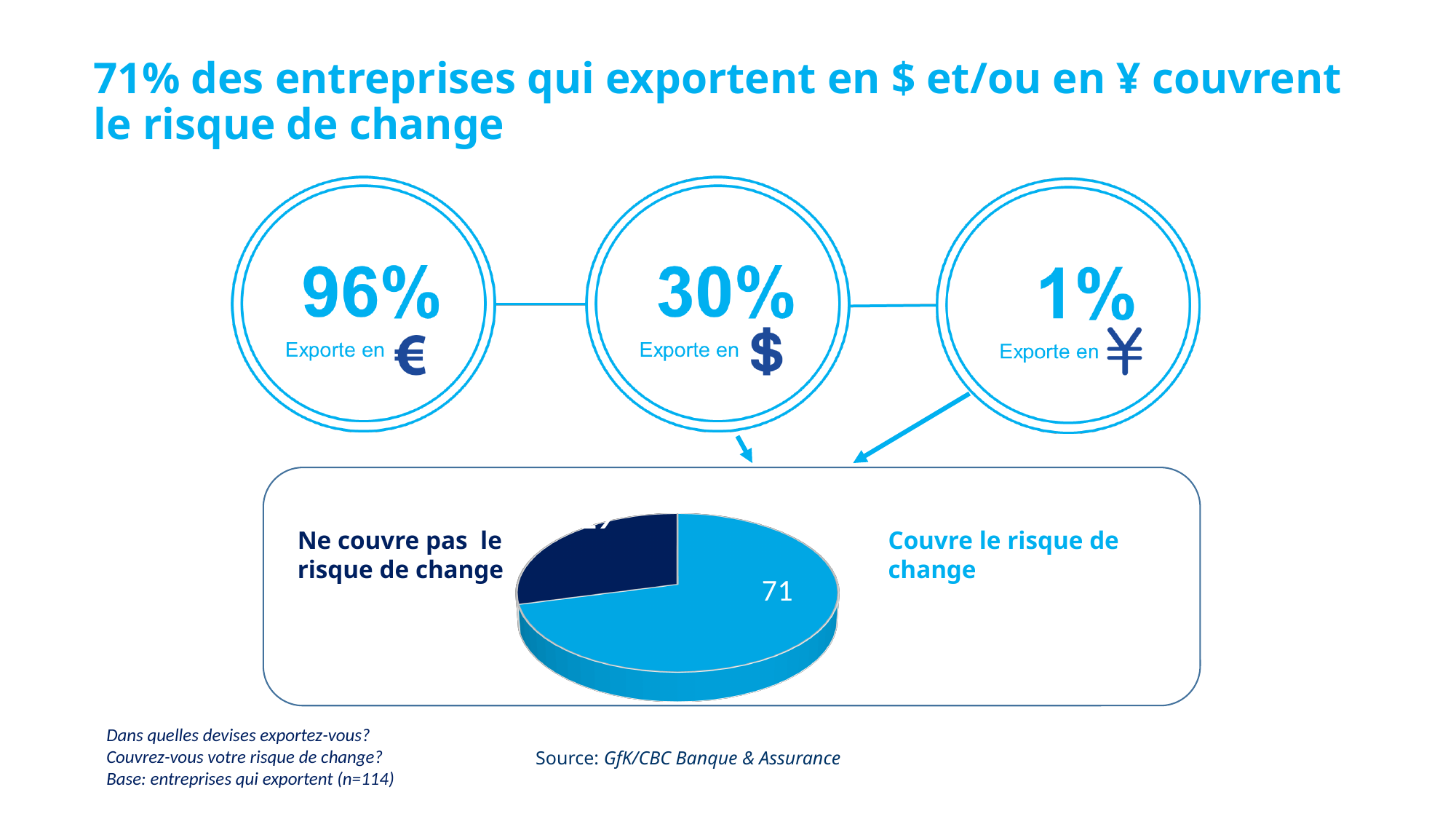
Which slice of the pie chart is the largest? Couvre le risque de change What kind of chart is shown inside the rounded box at the bottom of the slide? pie chart What colour is the 'Couvre le risque de change' slice of the pie chart? light blue What source is cited below the pie chart? GfK/CBC Banque & Assurance Which slice of the pie chart is the smallest? Ne couvre pas le risque de change How many slices does the pie chart have? 2 Does the 'Couvre le risque de change' slice take up more or less than half of the pie chart? more In the pie chart, which is larger: 'Couvre le risque de change' or 'Ne couvre pas le risque de change'? Couvre le risque de change What value is printed on the 'Couvre le risque de change' slice of the pie chart? 71